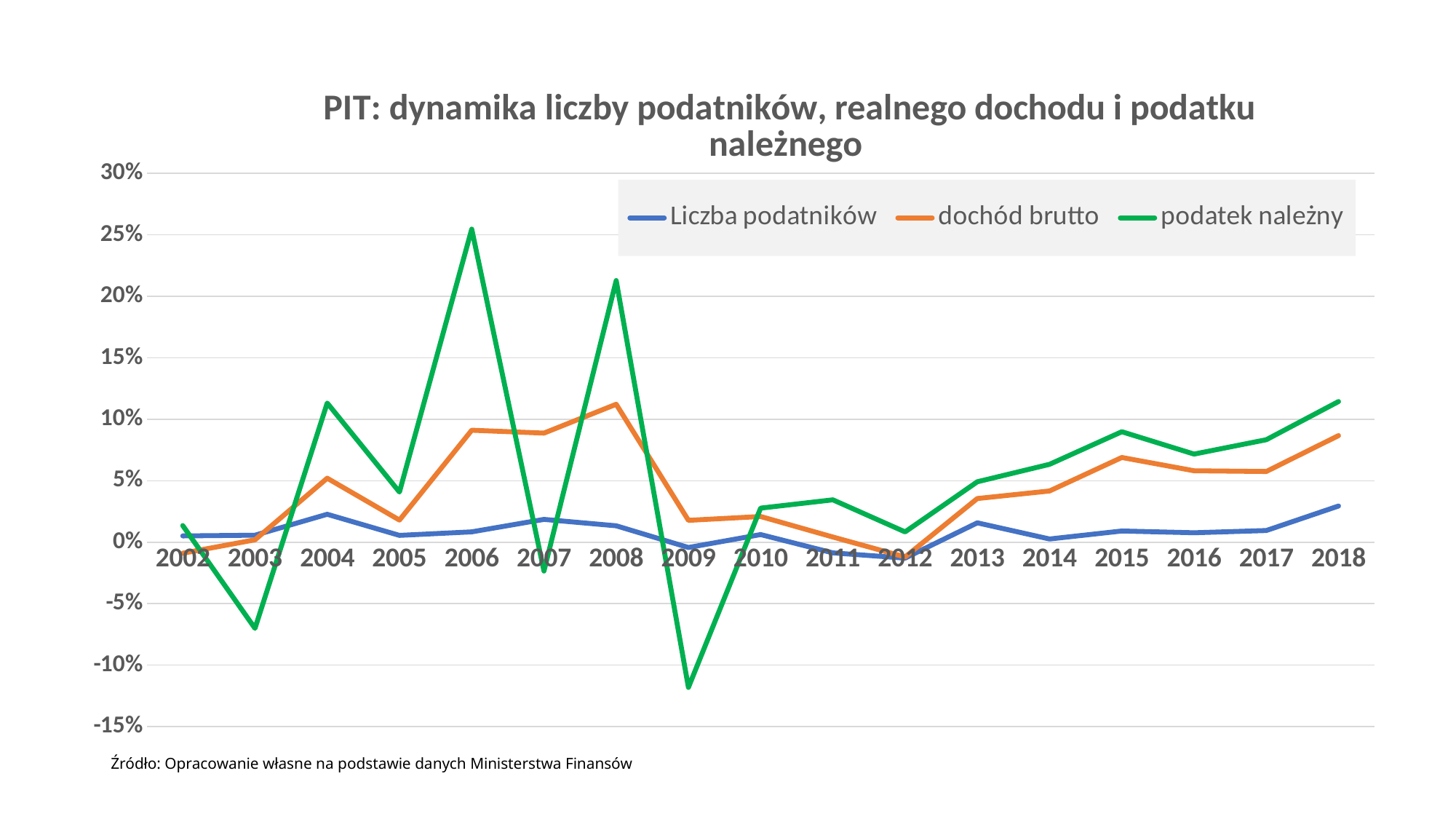
Is the value for 'dochód brutto' in 2008 greater or less than 10%? greater What kind of chart is shown on the slide? line chart Is the value for 'podatek należny' in 2006 greater or less than 20%? greater Does the 'podatek należny' series rise or fall from 2012 to 2018? rise In which year does the 'dochód brutto' series reach its highest value? 2008 In which year does the 'podatek należny' series reach its lowest value? 2009 Is the value for 'podatek należny' in 2009 greater or less than -10%? less In which year does the 'podatek należny' series reach its highest value? 2006 In 2006, which series has the higher value: 'podatek należny' or 'dochód brutto'? podatek należny What colour is the line for 'podatek należny'? green How many series does the legend list? 3 How many years are plotted along the x axis? 17